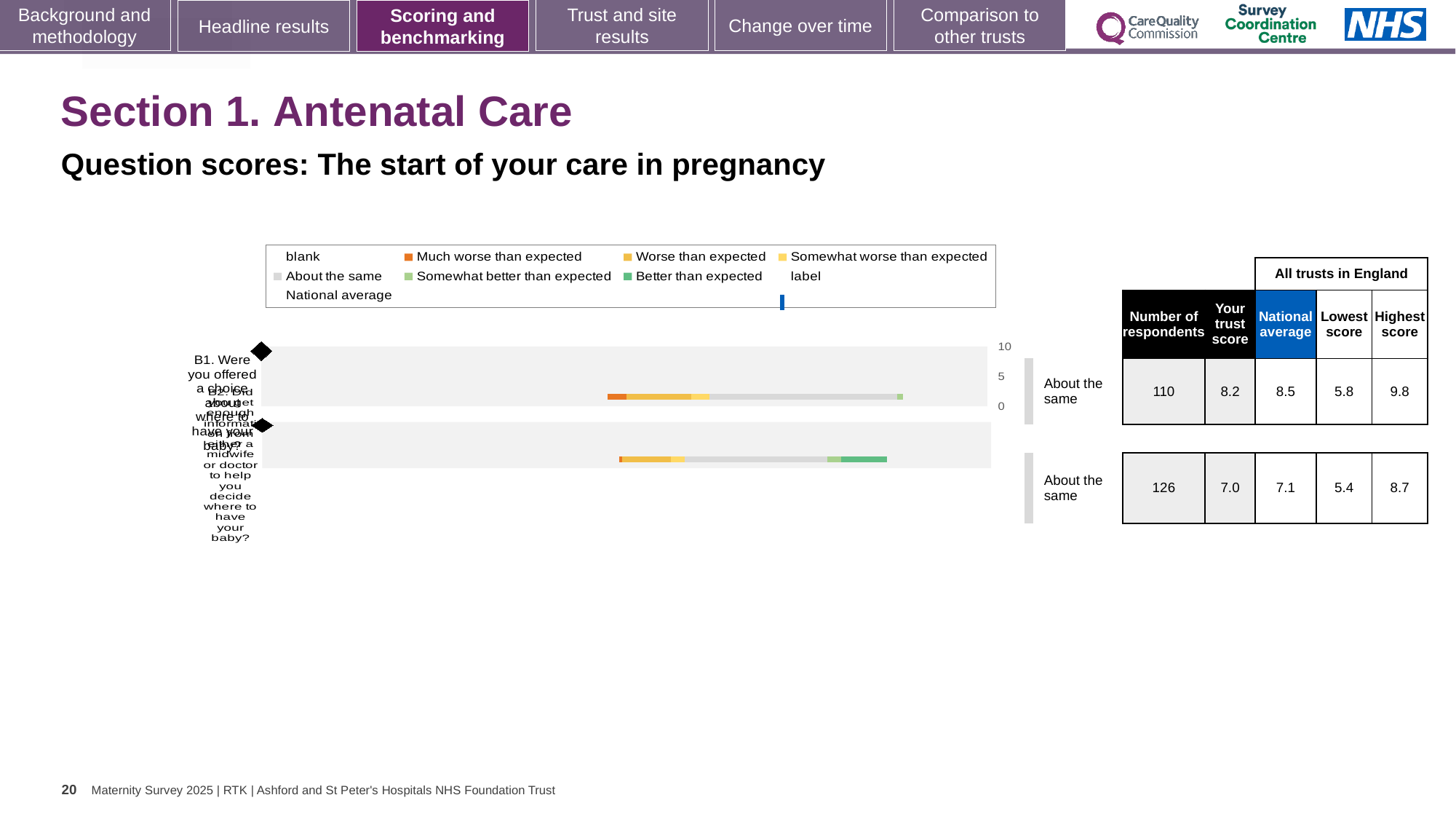
What is the national average for the second row (B2) in the table? 7.1 Which legend entry is shown with the orange colour? Much worse than expected What benchmark category label is shown beside both bars in the chart? About the same In the table next to the chart, what is the number of respondents for the first row (B1)? 110 What is the 'Your trust score' value for the first row (B1) in the table? 8.2 What is the difference between the highest and lowest scores for the second row (B2)? 3.3 What kind of chart is shown on the slide? bar chart Which row has the higher 'Your trust score', the first row (B1) or the second row (B2)? first row (B1) What is the difference between the national average and the trust score for the first row (B1)? 0.3 How many question bars are plotted in the chart? 2 What is the highest score across all trusts in England for the first row (B1)? 9.8 What is the lowest score across all trusts in England for the second row (B2)? 5.4